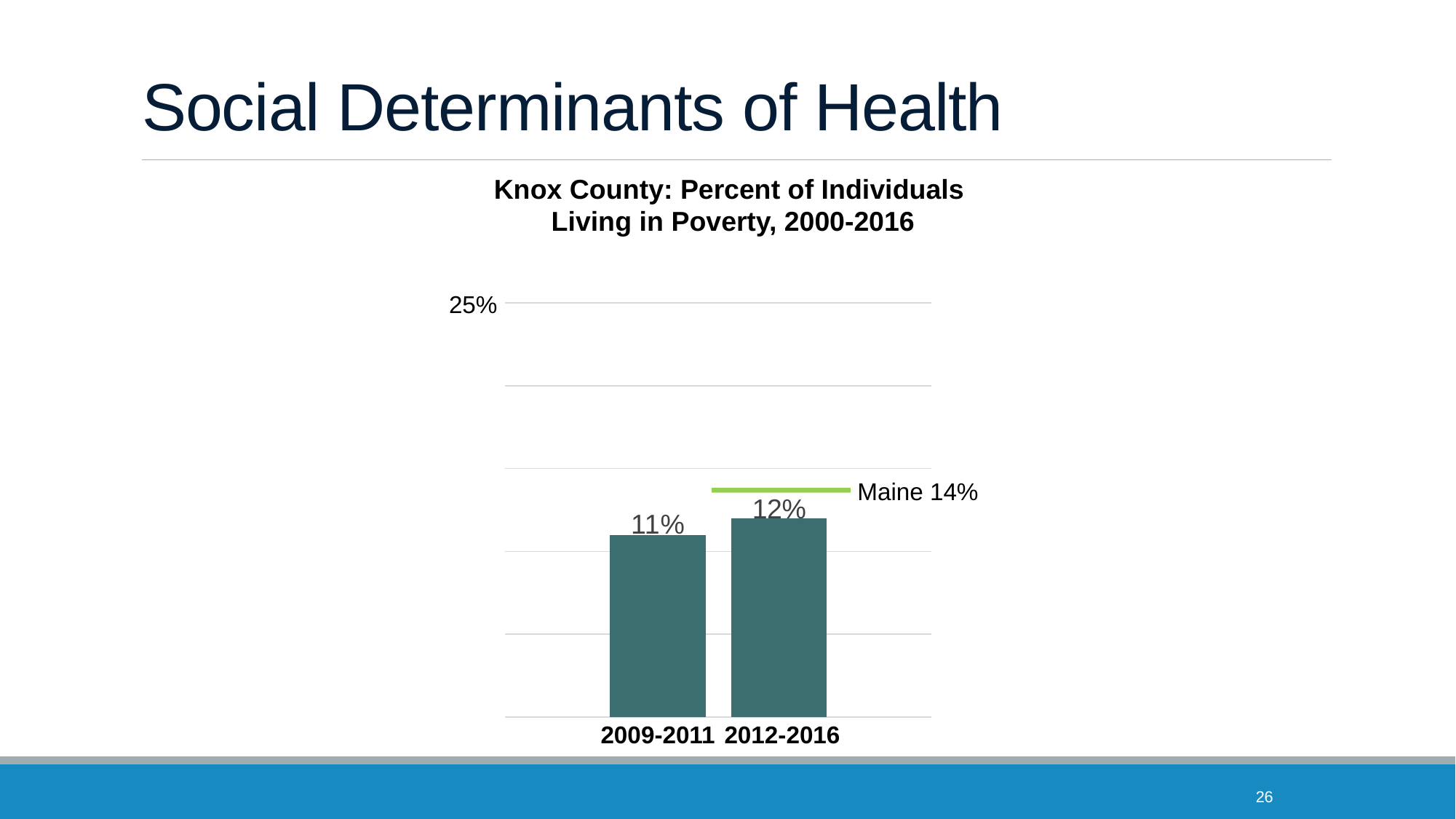
Do the poverty percentages rise or fall from 2009-2011 to 2012-2016? rise How many time periods are shown as bars on the chart? 2 Which period has the higher poverty percentage, 2009-2011 or 2012-2016? 2012-2016 Is the Knox County value for 2012-2016 larger or smaller than the Maine value? smaller What is the percent of individuals living in poverty in Knox County for 2012-2016? 12% What is the difference in poverty percentage between 2012-2016 and 2009-2011? 1% What is the percent of individuals living in poverty in Knox County for 2009-2011? 11% What is the title of the chart? Knox County: Percent of Individuals Living in Poverty, 2000-2016 Which period has the lower poverty percentage? 2009-2011 What kind of chart is shown on the slide? bar chart What is the Maine reference value shown on the chart? 14% Is the value for 2009-2011 greater or less than 25%? less